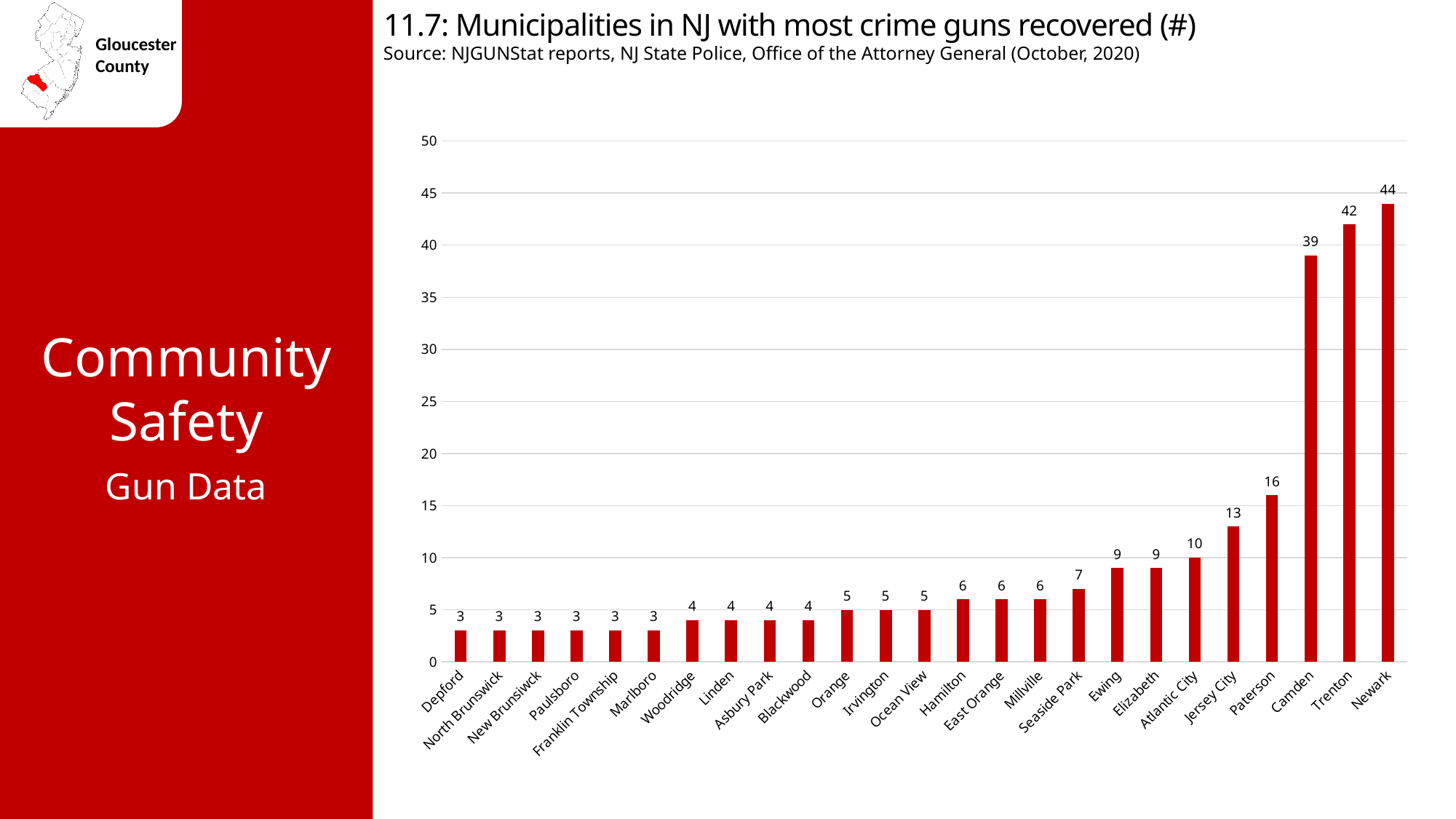
What is the value for Paulsboro? 3 Do the values generally rise or fall from left to right along the x axis? rise What is the difference between the values for Paterson and Atlantic City? 6 Which municipality has the highest number of crime guns recovered? Newark What is the lowest value shown on the chart? 3 What is the value for Jersey City? 13 How many municipalities are shown on the chart? 25 Which has a larger value, Camden or Paterson? Camden What kind of chart is shown on the slide? bar chart What is the difference between the values for Newark and Trenton? 2 How many crime guns were recovered in Camden? 39 What is the title of the chart? 11.7: Municipalities in NJ with most crime guns recovered (#)